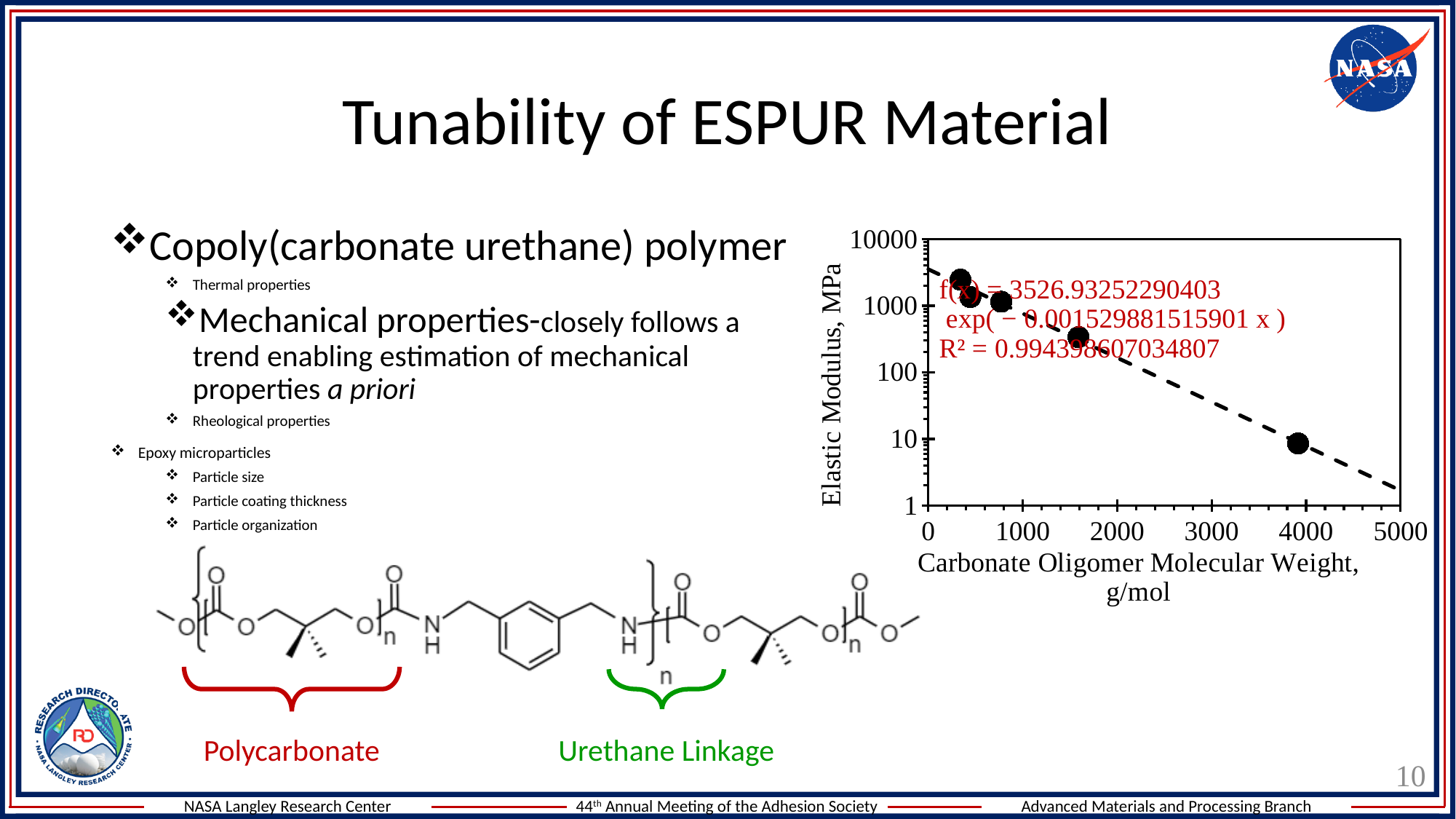
What is the highest value shown on the y-axis of the chart? 10000 Is the elastic modulus of the data point near 3900 g/mol greater or less than 100 MPa? less Is the elastic modulus of the data point near 800 g/mol greater or less than 100 MPa? greater Does the elastic modulus rise or fall as the carbonate oligomer molecular weight increases? fall Which data point has the lowest elastic modulus: the one near 1600 g/mol or the one near 3900 g/mol? the one near 3900 g/mol What is the title of the y-axis of the chart? Elastic Modulus, MPa What kind of chart is shown on the slide? scatter chart Is the elastic modulus of the data point near 1600 g/mol greater or less than 100 MPa? greater What is the title of the x-axis of the chart? Carbonate Oligomer Molecular Weight, g/mol Which has the larger elastic modulus: the data point near 800 g/mol or the data point near 1600 g/mol? the data point near 800 g/mol What R² value is printed on the chart for the fitted trendline? R² = 0.994398607034807